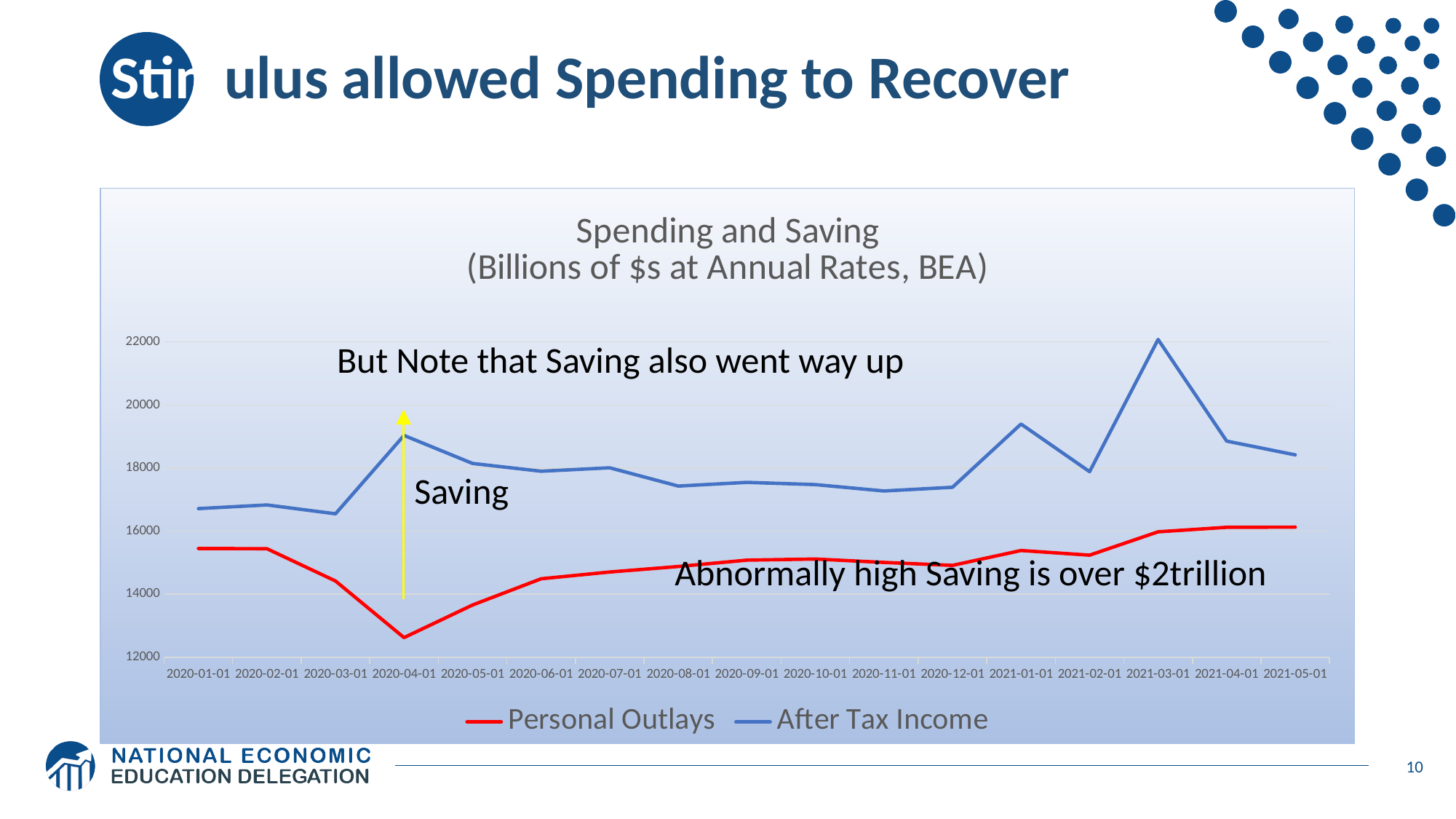
How many dates are plotted along the x axis? 17 On which date does Personal Outlays reach its lowest value? 2020-04-01 Is the value for After Tax Income on 2020-11-01 greater or less than 18000? less Does Personal Outlays rise or fall from 2020-04-01 to 2021-05-01? Rise Is the value for After Tax Income on 2021-03-01 greater or less than 20000? greater On 2020-04-01, which is larger: Personal Outlays or After Tax Income? After Tax Income Is the value for Personal Outlays on 2020-04-01 greater or less than 14000? less On which date does After Tax Income reach its highest value? 2021-03-01 How many series does the legend list? 2 What kind of chart is shown on the slide? Line chart What is the title of the chart? Spending and Saving (Billions of $s at Annual Rates, BEA)